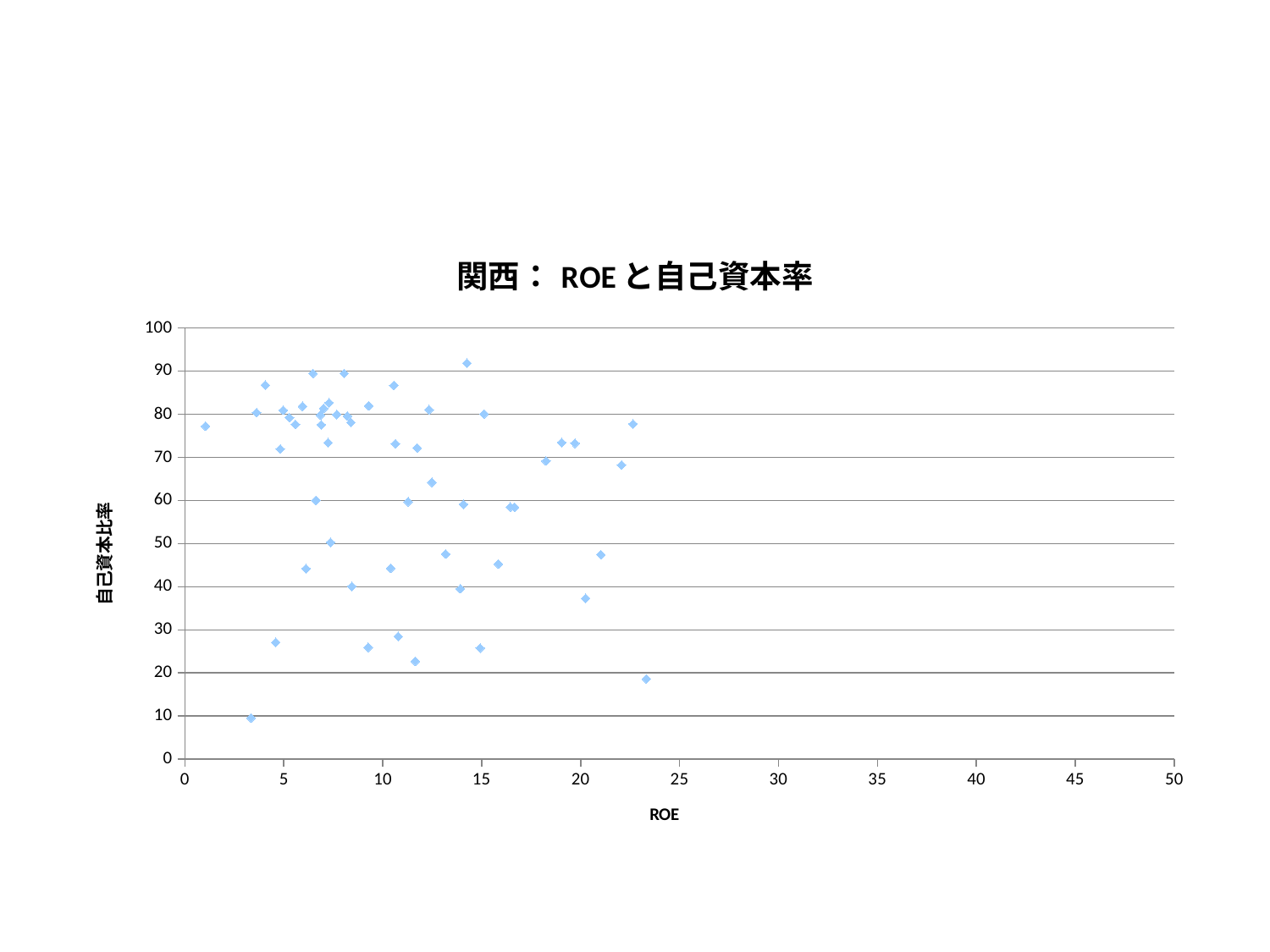
Is the 自己資本比率 of the point with the highest ROE greater or less than 30? less Are there any points with an ROE greater than 30? No What is the title of the chart? 関西： ROE と自己資本率 Is the 自己資本比率 of the point with the lowest ROE (near 1) greater or less than 70? greater What is the label of the vertical axis? 自己資本比率 What kind of chart is shown on the slide? Scatter chart